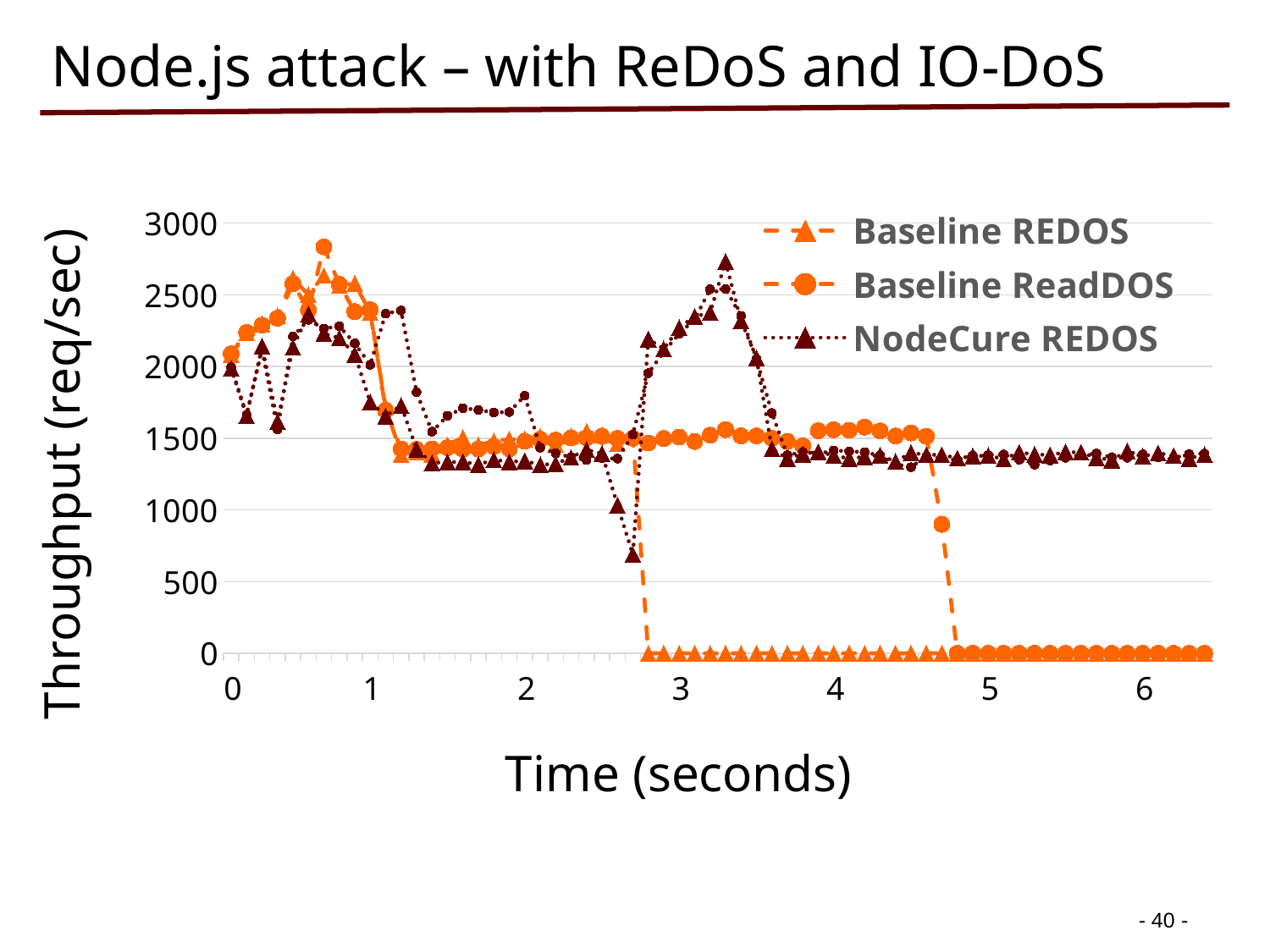
At time 4, which is larger: Baseline ReadDOS or Baseline REDOS? Baseline ReadDOS How many series does the legend list? 3 Is the value for Baseline REDOS at time 4 greater or less than 500? less What is the label of the x axis? Time (seconds) Is the value for Baseline ReadDOS at time 6 greater or less than 500? less Is the value for NodeCure REDOS at time 6 greater or less than 1000? greater Does the Baseline ReadDOS series rise or fall between time 4.5 and time 5? fall What kind of chart is shown on the slide? line chart Does the Baseline REDOS series rise or fall between time 2.5 and time 3? fall What is the label of the y axis? Throughput (req/sec)